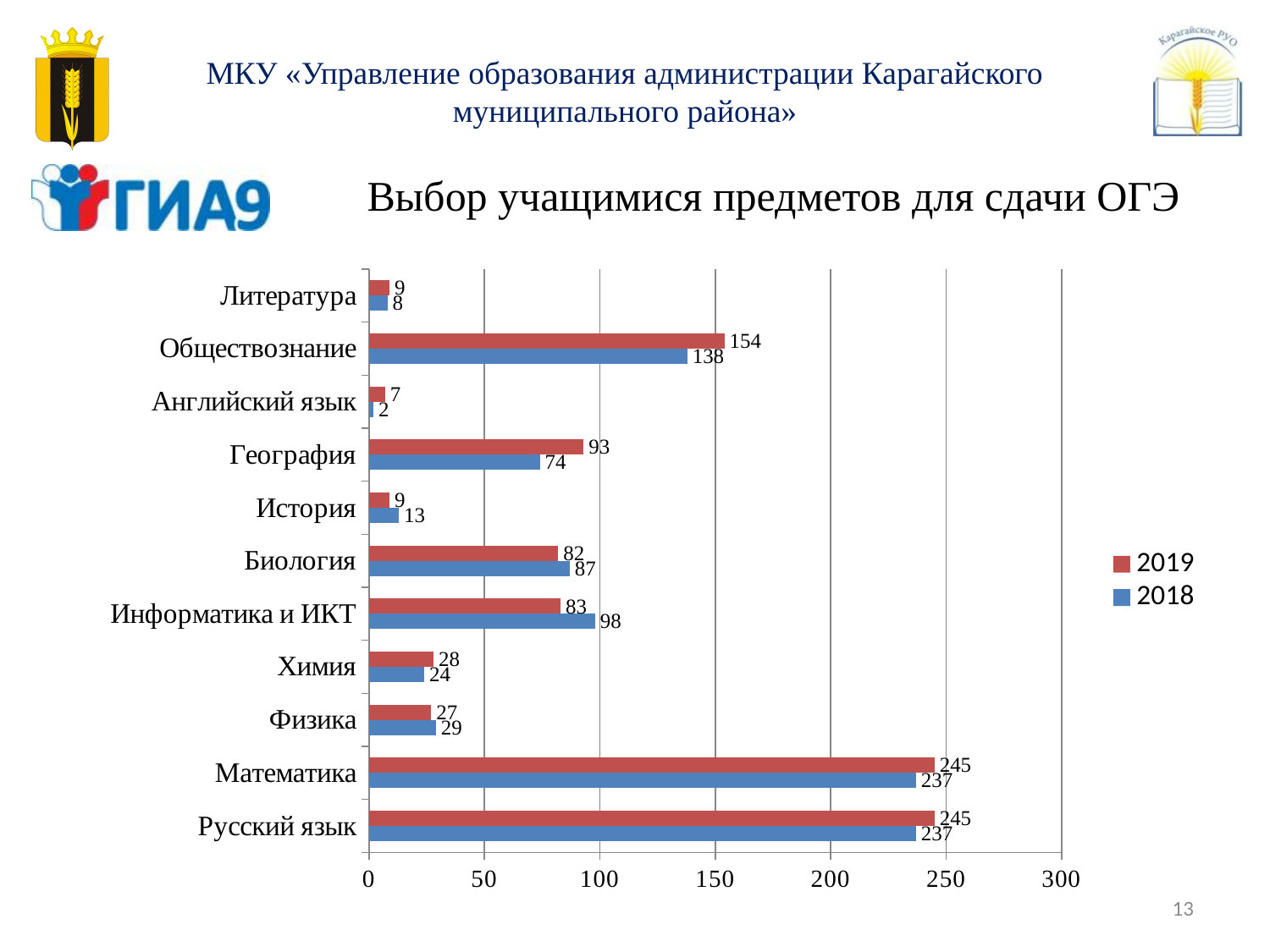
What is the value for Обществознание in the 2019 series? 154 How many series does the legend list? 2 What kind of chart is shown on the slide? bar chart What is the value for Информатика и ИКТ in the 2018 series? 98 What is the value for География in the 2018 series? 74 Which is larger for История: the 2019 value or the 2018 value? 2018 Which category has the lowest value in the 2018 series? Английский язык How many categories (subjects) are shown on the chart? 11 Which is larger for География: the 2019 value or the 2018 value? 2019 What is the difference between the 2019 and 2018 values for Обществознание? 16 Is the 2019 value for Математика greater or less than 200? greater What is the difference between the 2018 and 2019 values for Информатика и ИКТ? 15